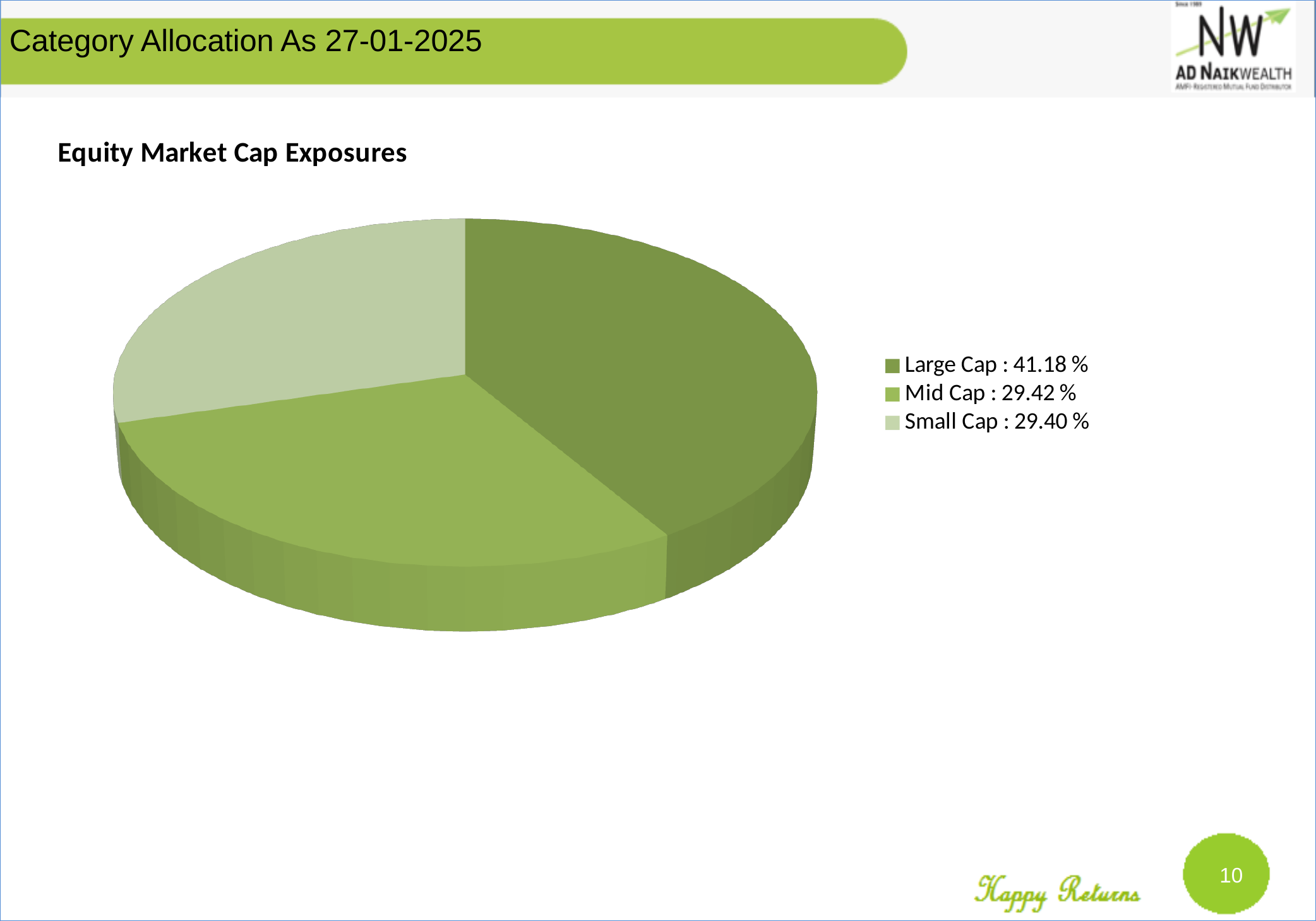
Which category has the smallest share of the pie chart? Small Cap What is the title of the chart on the slide? Equity Market Cap Exposures What kind of chart is shown on the slide? Pie chart What is the value for Small Cap in the pie chart? 29.40 % Which is larger, Large Cap or Mid Cap? Large Cap How many categories are shown in the pie chart? 3 Which category has the largest share of the pie chart? Large Cap What share of the pie does Large Cap represent? 41.18 % What is the difference between the Mid Cap and Small Cap values? 0.02 % What is the value for Large Cap in the pie chart? 41.18 % What is the value for Mid Cap in the pie chart? 29.42 % What is the difference between the Large Cap and Mid Cap values? 11.76 %